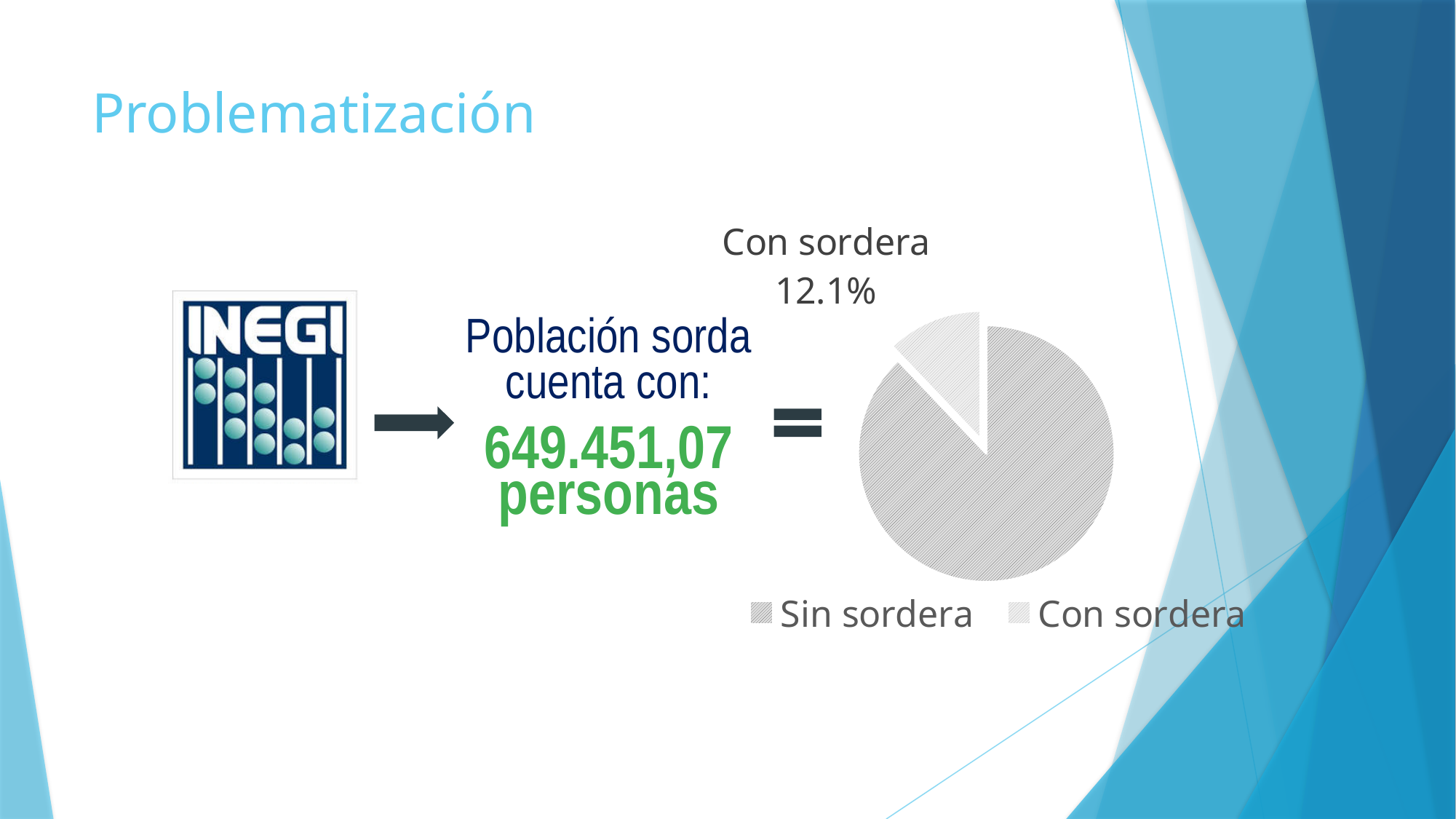
What is the value shown for Con sordera in the pie chart? 12.1% What share of the pie does the Con sordera slice represent? 12.1% What are the two legend entries of the pie chart? Sin sordera and Con sordera Which slice of the pie chart is the largest? Sin sordera Which slice of the pie chart has its value printed as a data label? Con sordera Which slice of the pie chart is the smallest? Con sordera How many slices does the pie chart have? 2 What kind of chart is shown on the slide? pie chart How many entries does the legend of the pie chart list? 2 Which is larger in the pie chart, Sin sordera or Con sordera? Sin sordera